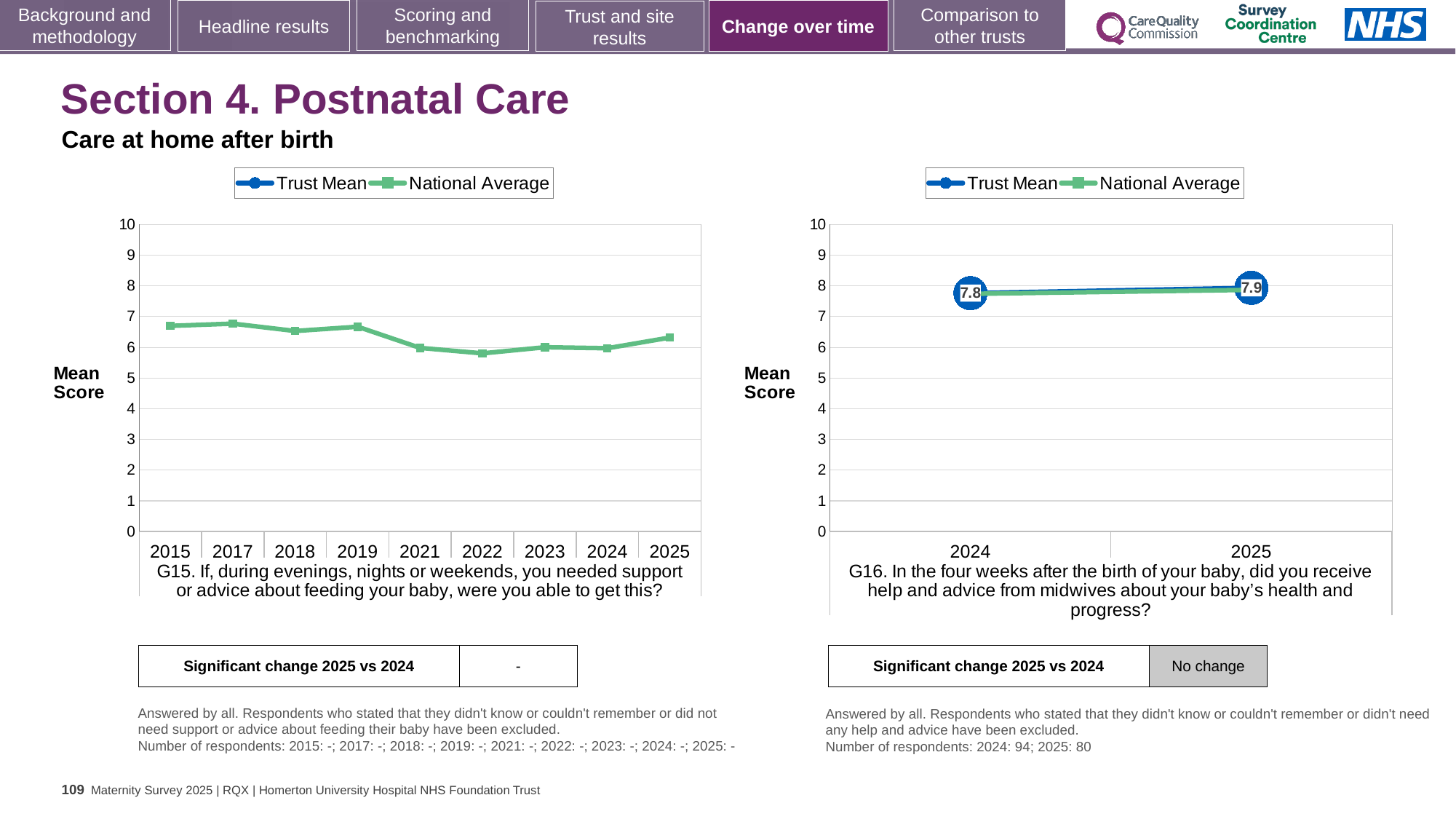
On the left chart (G15), is the National Average value for 2022 greater or less than 7? less On the right chart (G16), which year has the higher Trust Mean, 2024 or 2025? 2025 On the left chart (G15), what kind of chart is shown? line chart On the right chart (G16), what does the 'Significant change 2025 vs 2024' box say? No change On the right chart (G16), what is the Trust Mean for 2024? 7.8 On the left chart (G15), is the National Average value for 2015 greater or less than 6? greater On the left chart (G15), how many series does the legend list? 2 On the right chart (G16), how many years are shown on the x axis? 2 On the right chart (G16), what is the difference between the Trust Mean for 2025 and 2024? 0.1 On the left chart (G15), does the National Average rise or fall from 2019 to 2022? fall On the left chart (G15), how many survey years are shown on the x axis? 9 On the right chart (G16), what is the Trust Mean for 2025? 7.9